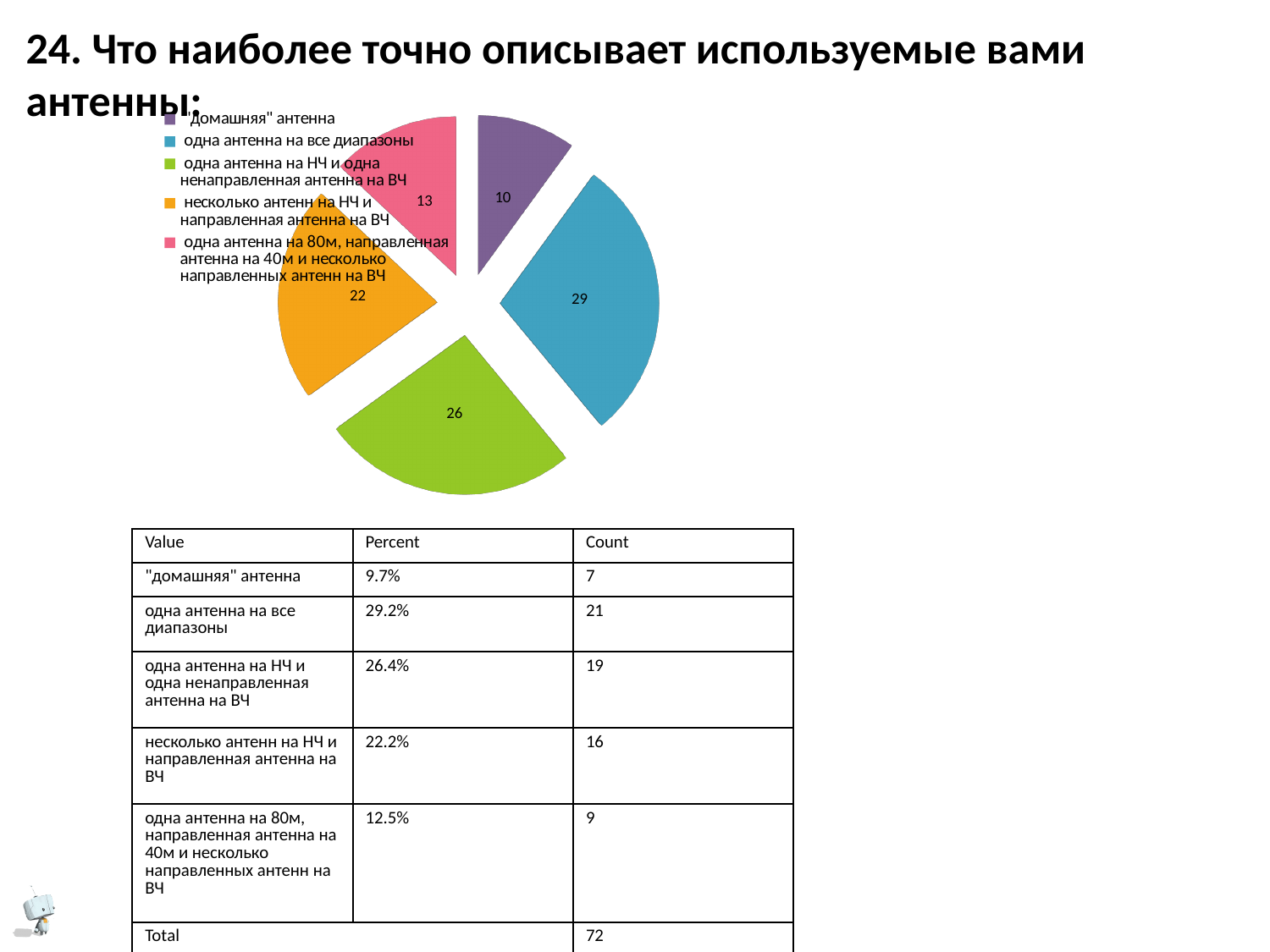
What value is labelled on the pie slice for "одна антенна на 80м, направленная антенна на 40м и несколько направленных антенн на ВЧ"? 13 What kind of chart is shown on the slide? pie chart What value is labelled on the pie slice for "несколько антенн на НЧ и направленная антенна на ВЧ"? 22 Which category has the largest slice in the pie chart? одна антенна на все диапазоны How many slices does the pie chart have? 5 What value is labelled on the pie slice for "одна антенна на все диапазоны"? 29 What is the difference between the labelled values of the "одна антенна на все диапазоны" slice and the "несколько антенн на НЧ и направленная антенна на ВЧ" slice? 7 Which category has the smallest slice in the pie chart? "домашняя" антенна What colour is the slice for "одна антенна на все диапазоны" in the pie chart? blue What value is labelled on the pie slice for "одна антенна на НЧ и одна ненаправленная антенна на ВЧ"? 26 What value is labelled on the pie slice for ""домашняя" антенна"? 10 How many entries does the legend of the pie chart list? 5